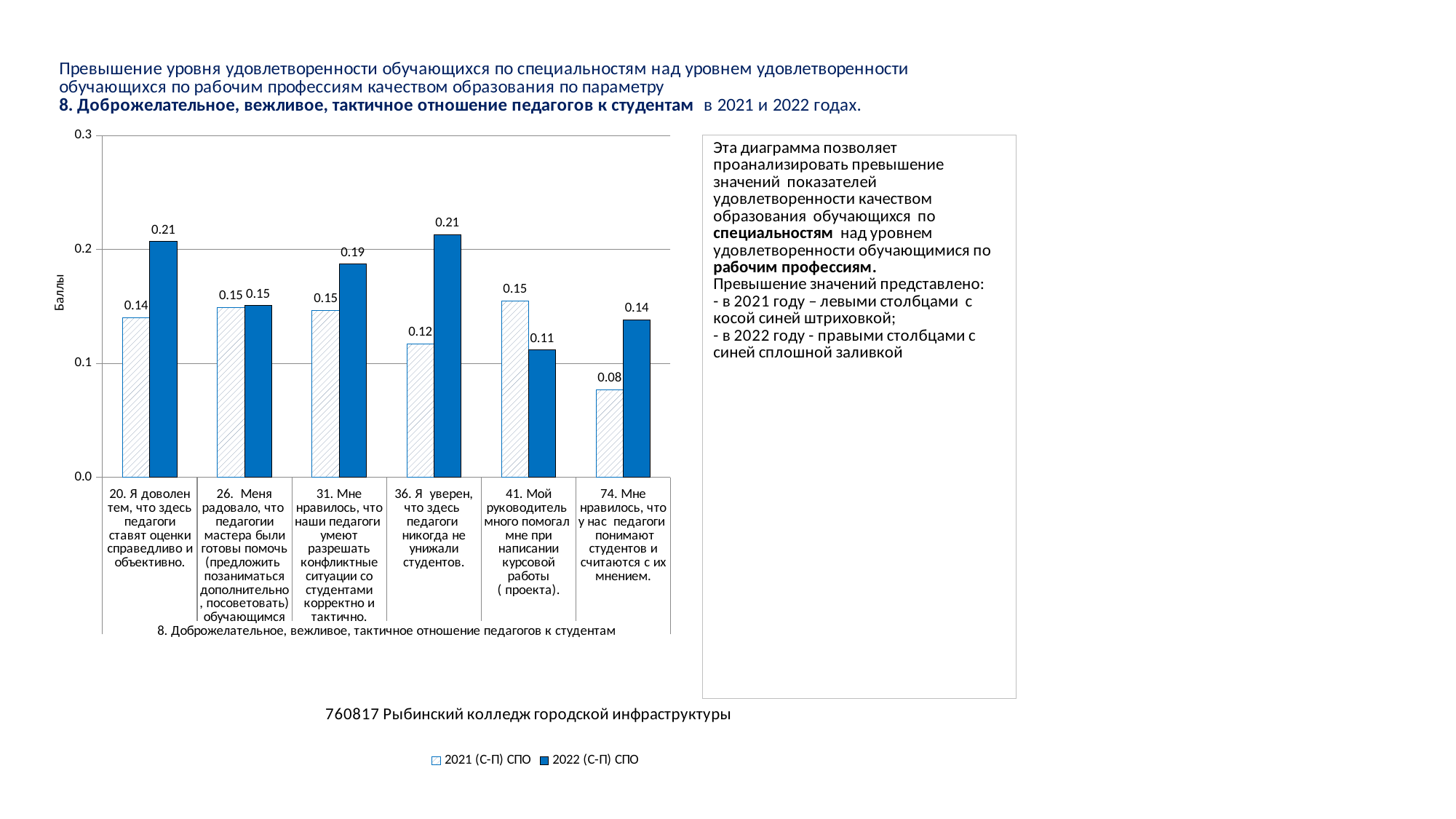
What type of chart is shown on the slide? bar chart How many categories (statements) are shown on the x axis? 6 What is the value of the 2021 (С-П) СПО series for statement 36 (Я уверен, что здесь педагоги никогда не унижали студентов)? 0.12 What is the label of the y axis of the chart? Баллы Which statement has the lowest value in the 2021 (С-П) СПО series? 74. Мне нравилось, что у нас педагоги понимают студентов и считаются с их мнением. How many series does the legend list? 2 What is the value of the 2022 (С-П) СПО series for statement 41 (Мой руководитель много помогал мне при написании курсовой работы)? 0.11 Which statement has the lowest value in the 2022 (С-П) СПО series? 41. Мой руководитель много помогал мне при написании курсовой работы (проекта). Is the 2021 (С-П) СПО value for statement 74 (Мне нравилось, что у нас педагоги понимают студентов) greater or less than 0.1? less What is the value of the 2022 (С-П) СПО series for statement 20 (Я доволен тем, что здесь педагоги ставят оценки справедливо и объективно)? 0.21 What is the difference between the 2022 and 2021 values for statement 36 (Я уверен, что здесь педагоги никогда не унижали студентов)? 0.09 For statement 41 (Мой руководитель много помогал мне при написании курсовой работы), which series has the larger value, 2021 (С-П) СПО or 2022 (С-П) СПО? 2021 (С-П) СПО